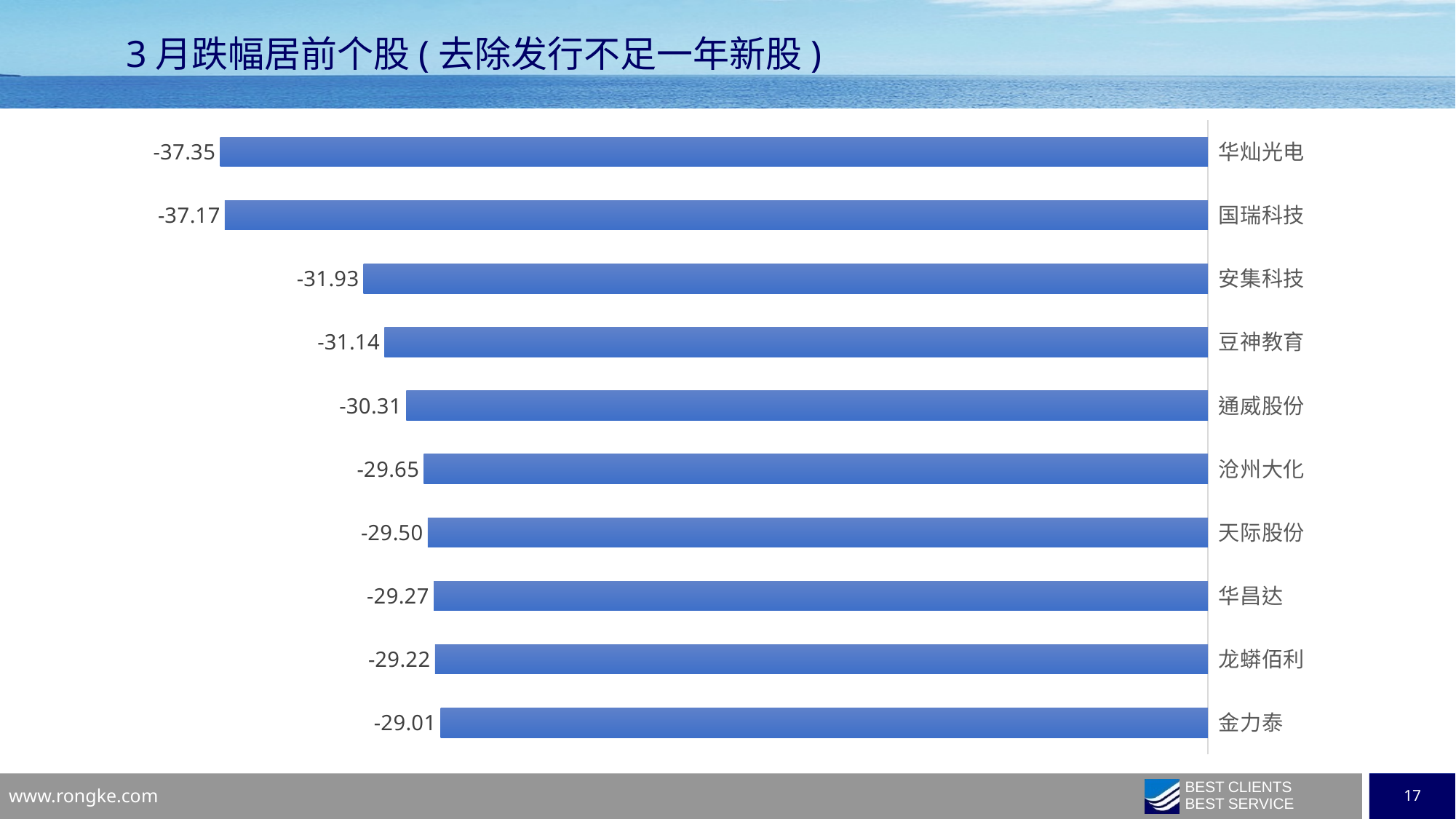
What kind of chart is shown on the slide? Bar chart What is the value shown for 天际股份? -29.50 Which stock has the largest decline (the lowest value) on the chart? 华灿光电 Which stock has the smallest decline (the highest value) on the chart? 金力泰 What is the value shown for 华灿光电? -37.35 How many stocks are shown on the chart? 10 What is the difference between the values for 安集科技 and 豆神教育? 0.79 What is the difference between the values for 华灿光电 and 国瑞科技? 0.18 What is the title of the slide? 3月跌幅居前个股(去除发行不足一年新股) What is the value shown for 通威股份? -30.31 Which has a larger decline, 安集科技 or 沧州大化? 安集科技 What is the value shown for 金力泰? -29.01